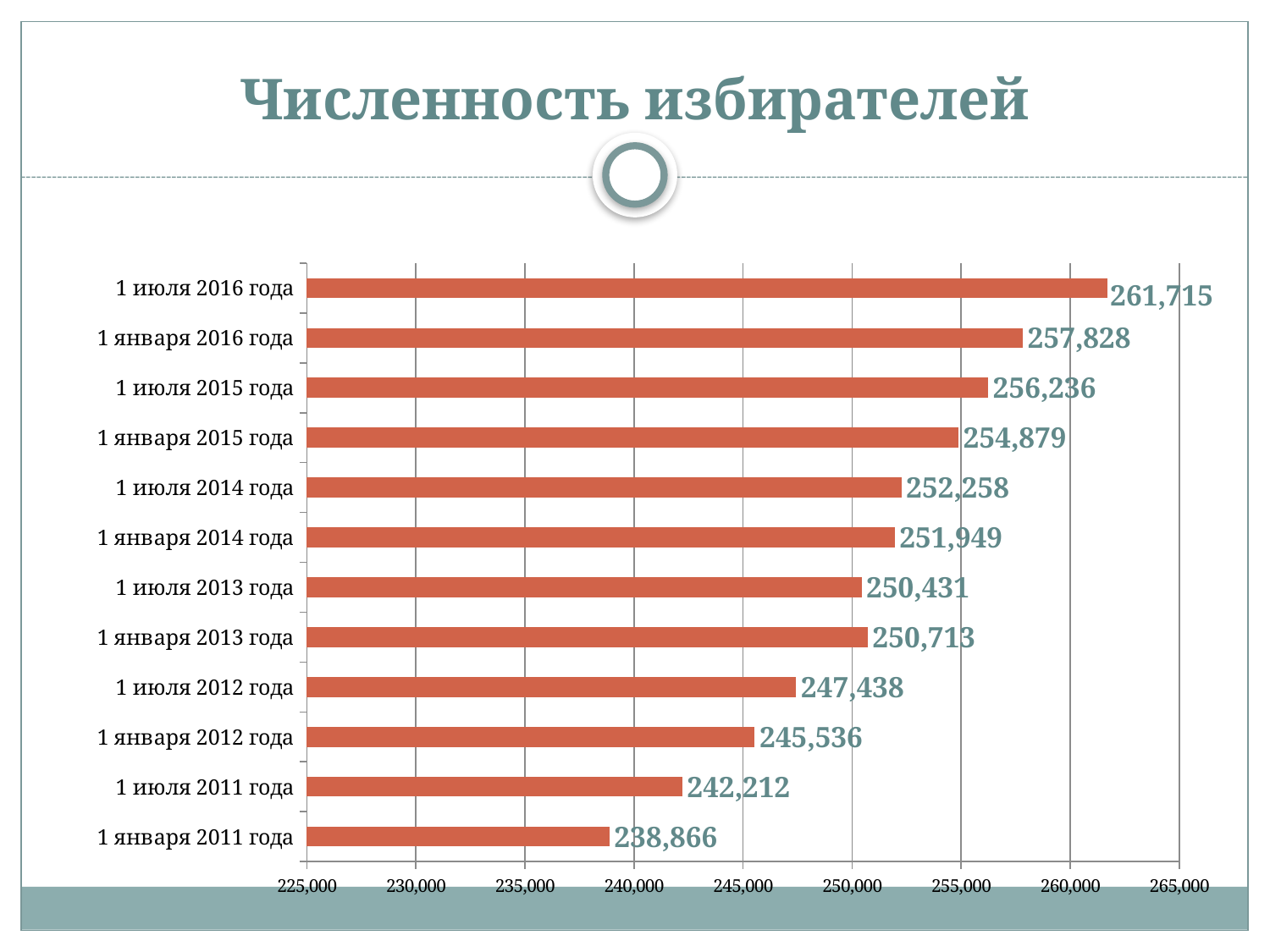
What is the value for 1 января 2011 года? 238,866 What is the title of the chart? Численность избирателей What is the value for 1 января 2014 года? 251,949 Which category has the highest value? 1 июля 2016 года What is the value for 1 июля 2016 года? 261,715 Is the value for 1 июля 2014 года greater or less than 250,000? greater What is the difference between the values for 1 января 2013 года and 1 июля 2013 года? 282 How many categories are shown in the chart? 12 What is the difference between the values for 1 июля 2016 года and 1 января 2011 года? 22,849 What kind of chart is shown on the slide? bar chart Which is larger, the value for 1 января 2013 года or 1 июля 2013 года? 1 января 2013 года Which category has the lowest value? 1 января 2011 года